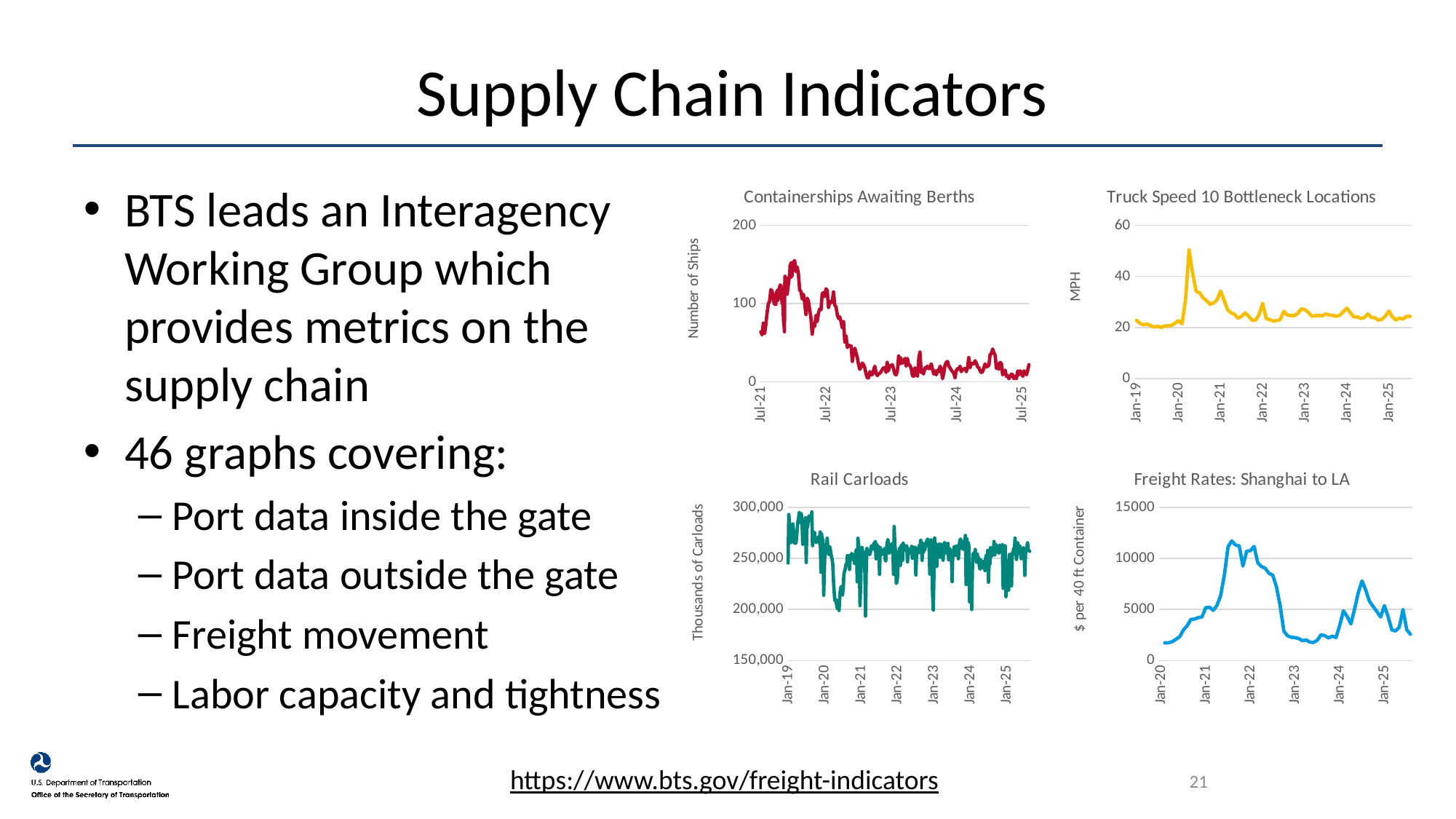
In the 'Freight Rates: Shanghai to LA' chart, do the values rise or fall between Jan-22 and Jan-23? fall What is the y-axis label of the 'Freight Rates: Shanghai to LA' chart? $ per 40 ft Container In the 'Truck Speed 10 Bottleneck Locations' chart, is the peak value greater or less than 40? greater In the 'Freight Rates: Shanghai to LA' chart, is the peak value greater or less than 10000? greater What is the y-axis label of the 'Truck Speed 10 Bottleneck Locations' chart? MPH In the 'Containerships Awaiting Berths' chart, do the values rise or fall between Jul-22 and Jul-23? fall In the 'Truck Speed 10 Bottleneck Locations' chart, is the value at Jan-25 greater or less than 40? less How many charts are shown on the slide? 4 What kind of chart is the 'Containerships Awaiting Berths' chart? line chart